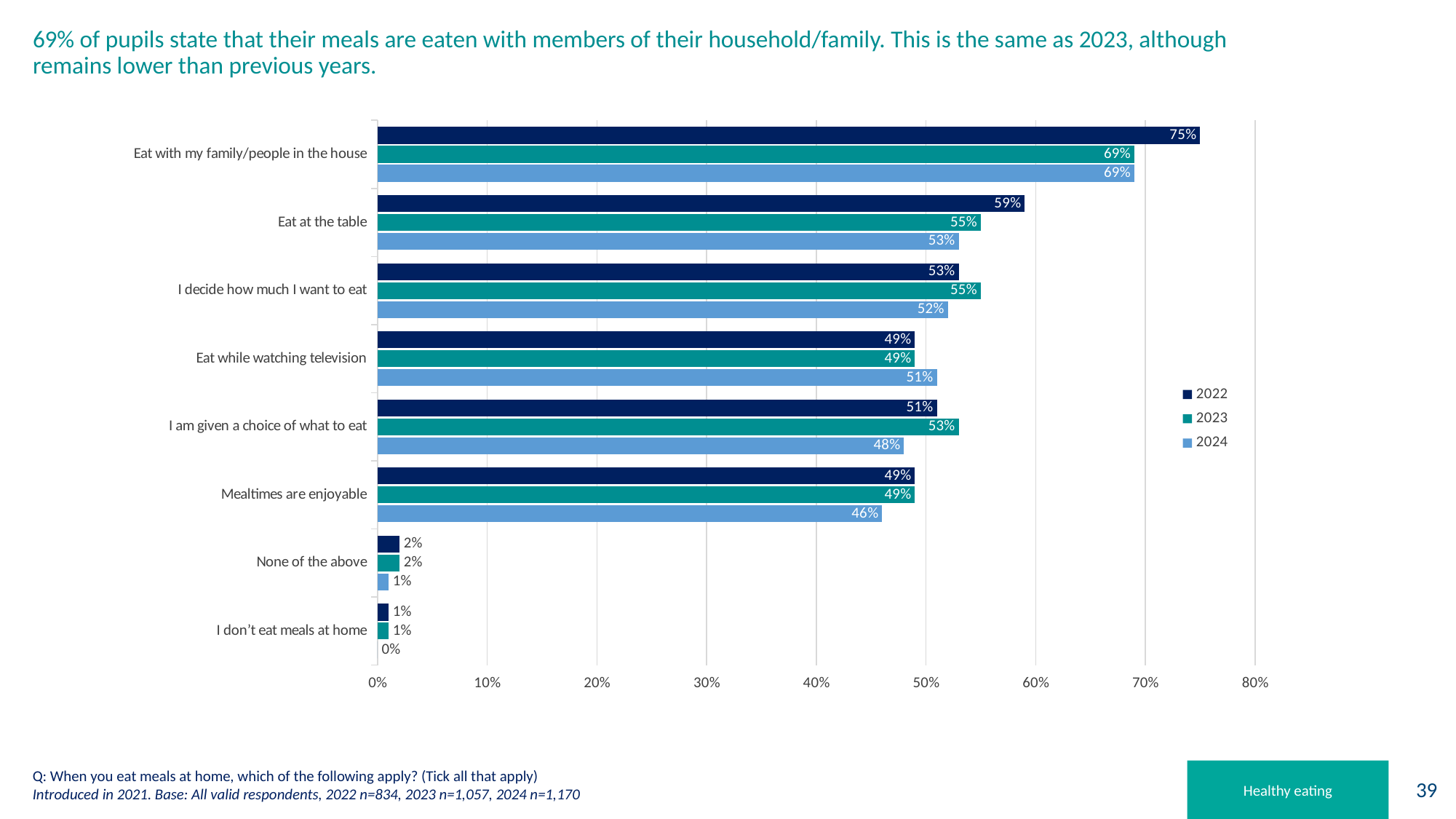
Which category has the highest value in 2022? Eat with my family/people in the house How many categories are shown on the chart? 8 What percentage of pupils in 2024 said they eat with their family/people in the house? 69% Which years are listed in the chart legend? 2022, 2023, 2024 What was the value for 'Mealtimes are enjoyable' in 2024? 46% How many series does the legend list? 3 What was the value for 'Eat at the table' in 2022? 59% What is the difference between the 2022 and 2024 values for 'Eat with my family/people in the house'? 6% Which is larger for 'I am given a choice of what to eat': the 2023 value or the 2024 value? 2023 What kind of chart is shown on the slide? Bar chart What percentage of pupils in 2023 said 'I decide how much I want to eat'? 55% Which category has the lowest value in 2024? I don't eat meals at home